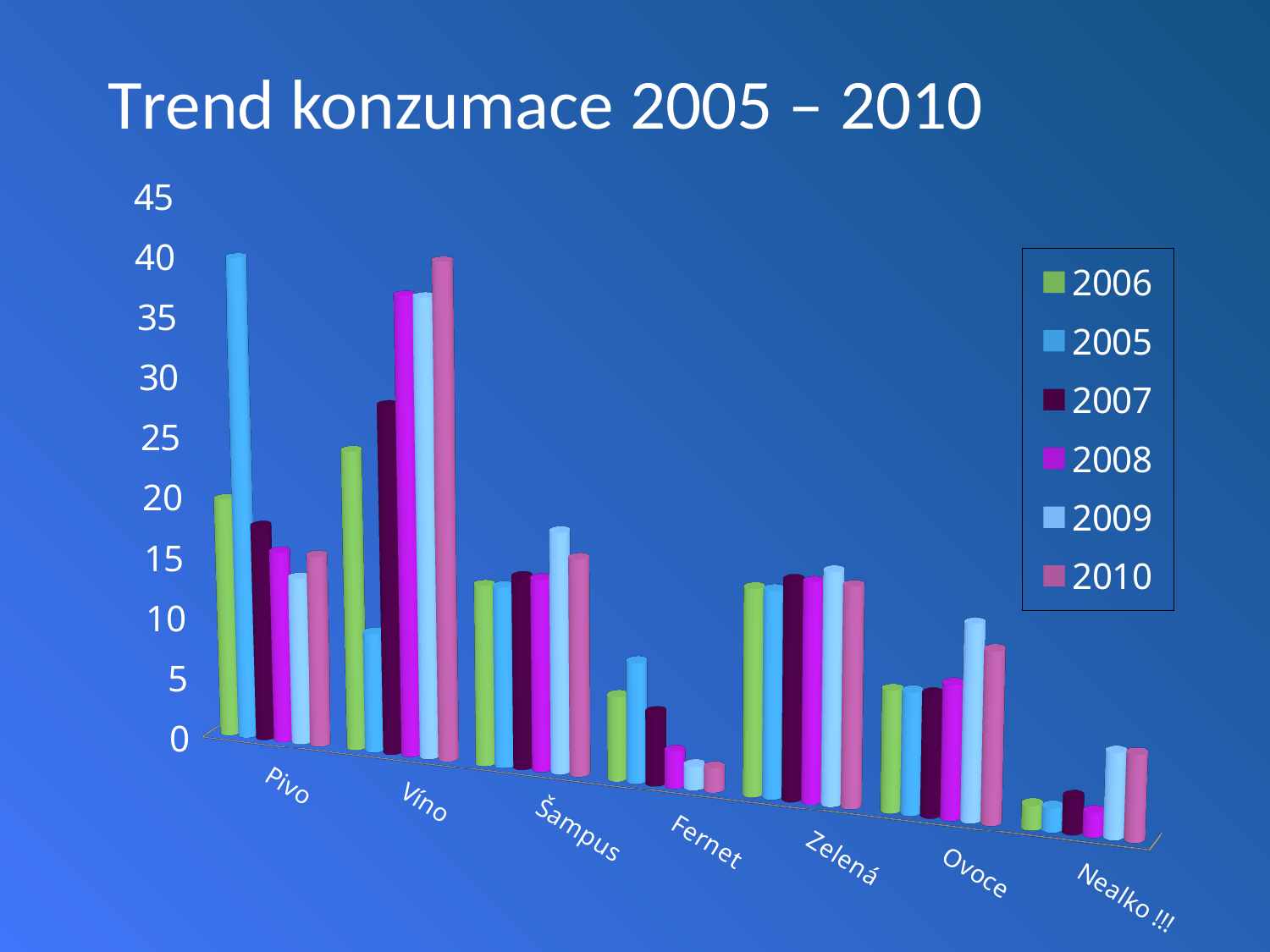
Is the value for Pivo in 2005 greater or less than 30? greater Is the value for Fernet in 2010 greater or less than 5? less How many categories are shown on the x axis of the chart? 7 Which series is listed first in the legend? 2006 For the category Víno, which year has the lowest bar? 2005 Is the value for Nealko !!! in 2006 greater or less than 5? less For Víno, which is larger: the 2006 bar or the 2007 bar? 2007 What kind of chart is shown on the slide? bar chart What is the title of the chart? Trend konzumace 2005 – 2010 How many series does the legend list? 6 For the category Fernet, which year has the highest bar? 2005 For the category Pivo, which year has the highest bar? 2005